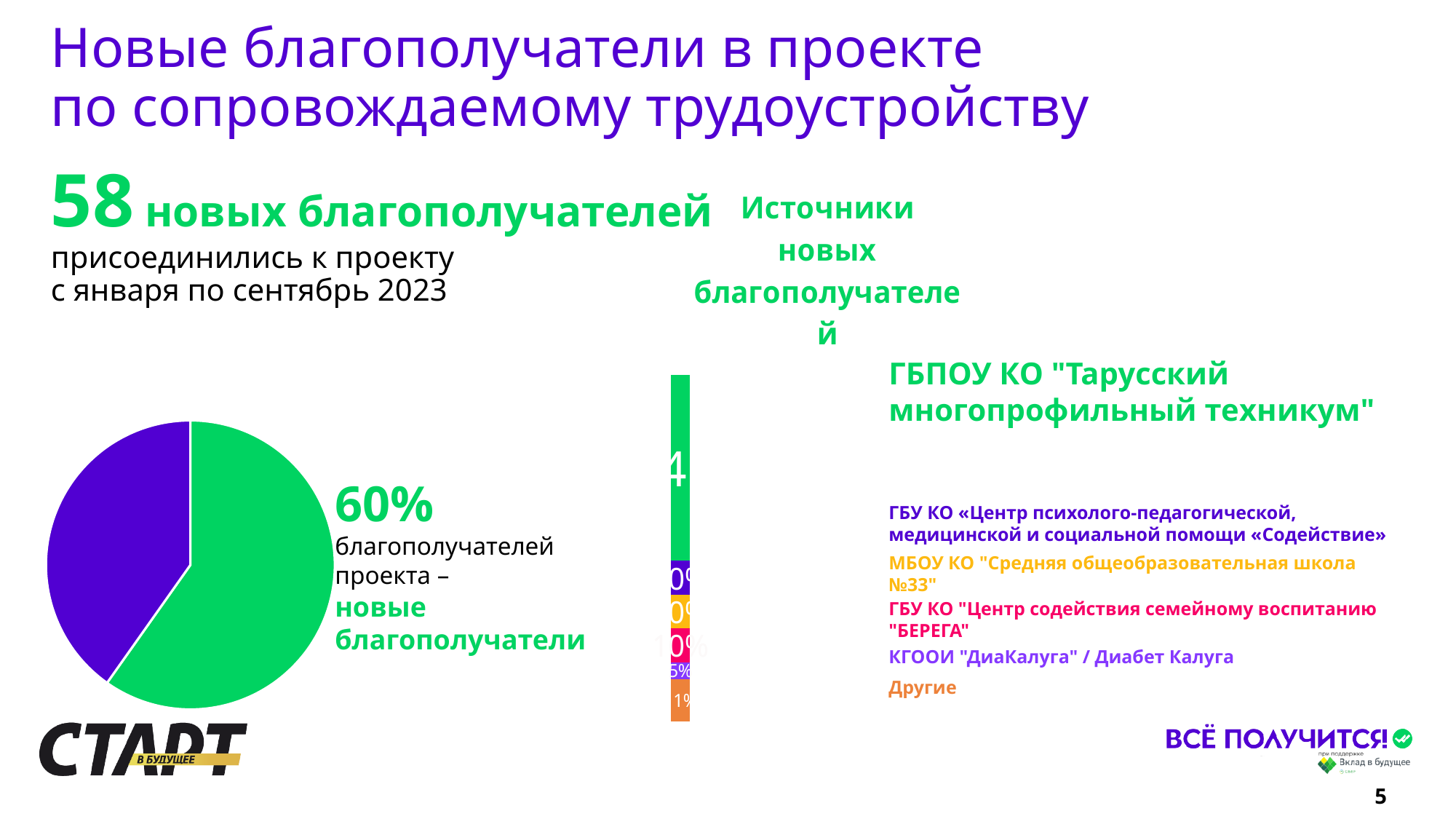
In the chart "Источники новых благополучателей", which is larger: the value for "БЕРЕГА" or the value for КГООИ "ДиаКалуга"? "БЕРЕГА" In the chart "Источники новых благополучателей", which source accounts for the largest segment of the bar? ГБПОУ КО "Тарусский многопрофильный техникум" In the chart "Источники новых благополучателей", what is the value for КГООИ "ДиаКалуга" / Диабет Калуга? 5% How many slices does the pie chart on the left have? 2 In the pie chart on the left, which slice is larger, the green one or the purple one? the green one In the chart "Источники новых благополучателей", what colour is the segment for ГБПОУ КО "Тарусский многопрофильный техникум"? green How many sources does the legend of the chart "Источники новых благополучателей" list? 6 In the pie chart on the left, what share of the project's beneficiaries are new beneficiaries? 60% What kind of chart is the chart titled "Источники новых благополучателей"? stacked bar chart What kind of chart is the chart on the left of the slide? pie chart In the chart "Источники новых благополучателей", what is the difference between the value for "БЕРЕГА" and the value for КГООИ "ДиаКалуга"? 5% In the chart "Источники новых благополучателей", what is the value for ГБУ КО "Центр содействия семейному воспитанию "БЕРЕГА"? 10%